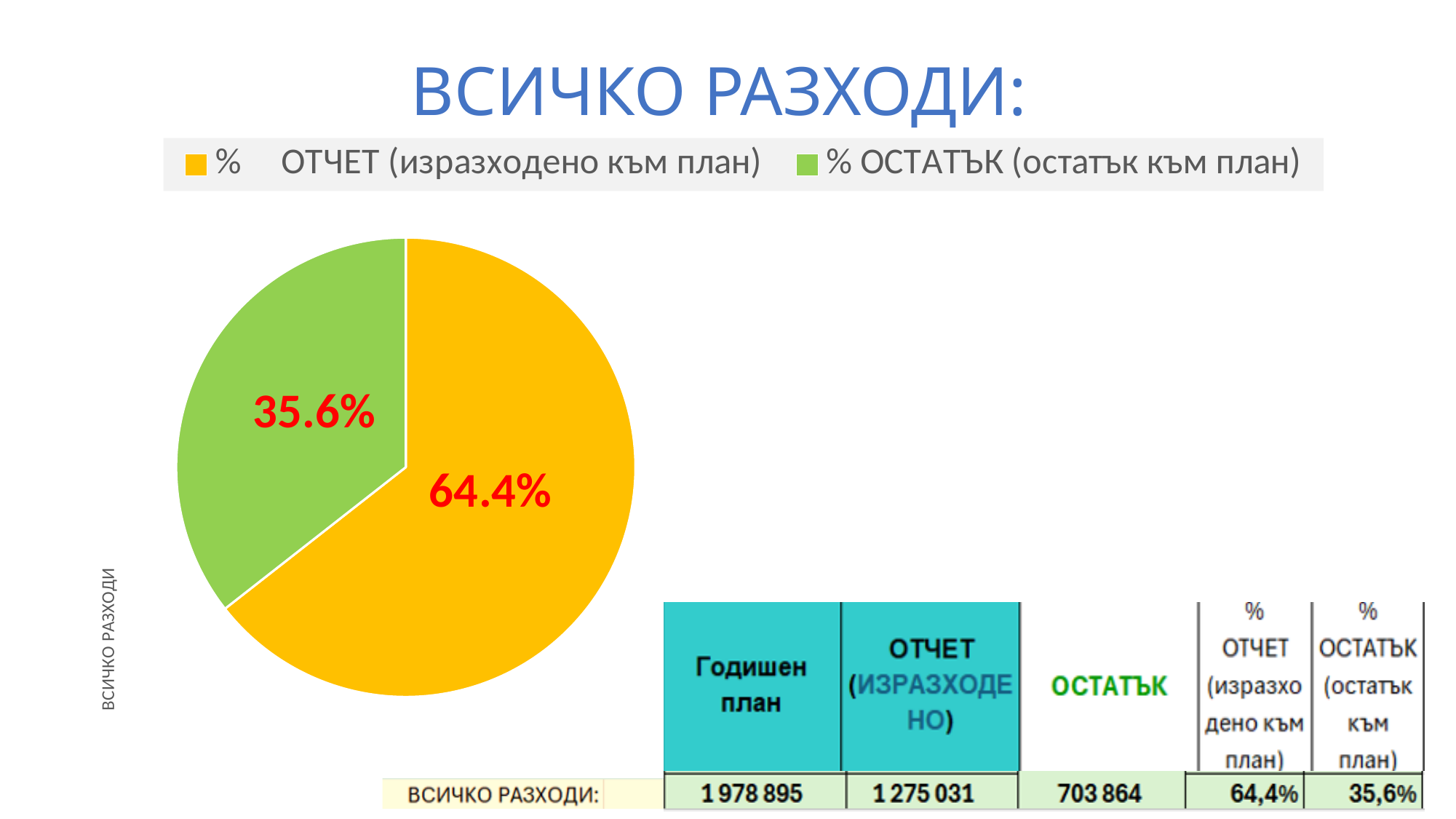
Which is larger, the ОТЧЕТ slice or the ОСТАТЪК slice? ОТЧЕТ What colour is the slice for "% ОСТАТЪК (остатък към план)"? green How many entries does the chart legend list? 2 What is the title of the chart? ВСИЧКО РАЗХОДИ: Which slice of the pie is the largest? % ОТЧЕТ (изразходено към план) What percentage is shown for the slice "% ОСТАТЪК (остатък към план)"? 35.6% What kind of chart is shown on the slide? pie chart What percentage is shown for the slice "% ОТЧЕТ (изразходено към план)"? 64.4% What share of the pie does the orange slice represent? 64.4% How many slices does the pie chart have? 2 What is the difference in percentage points between the ОТЧЕТ slice and the ОСТАТЪК slice? 28.8 Which slice of the pie is the smallest? % ОСТАТЪК (остатък към план)